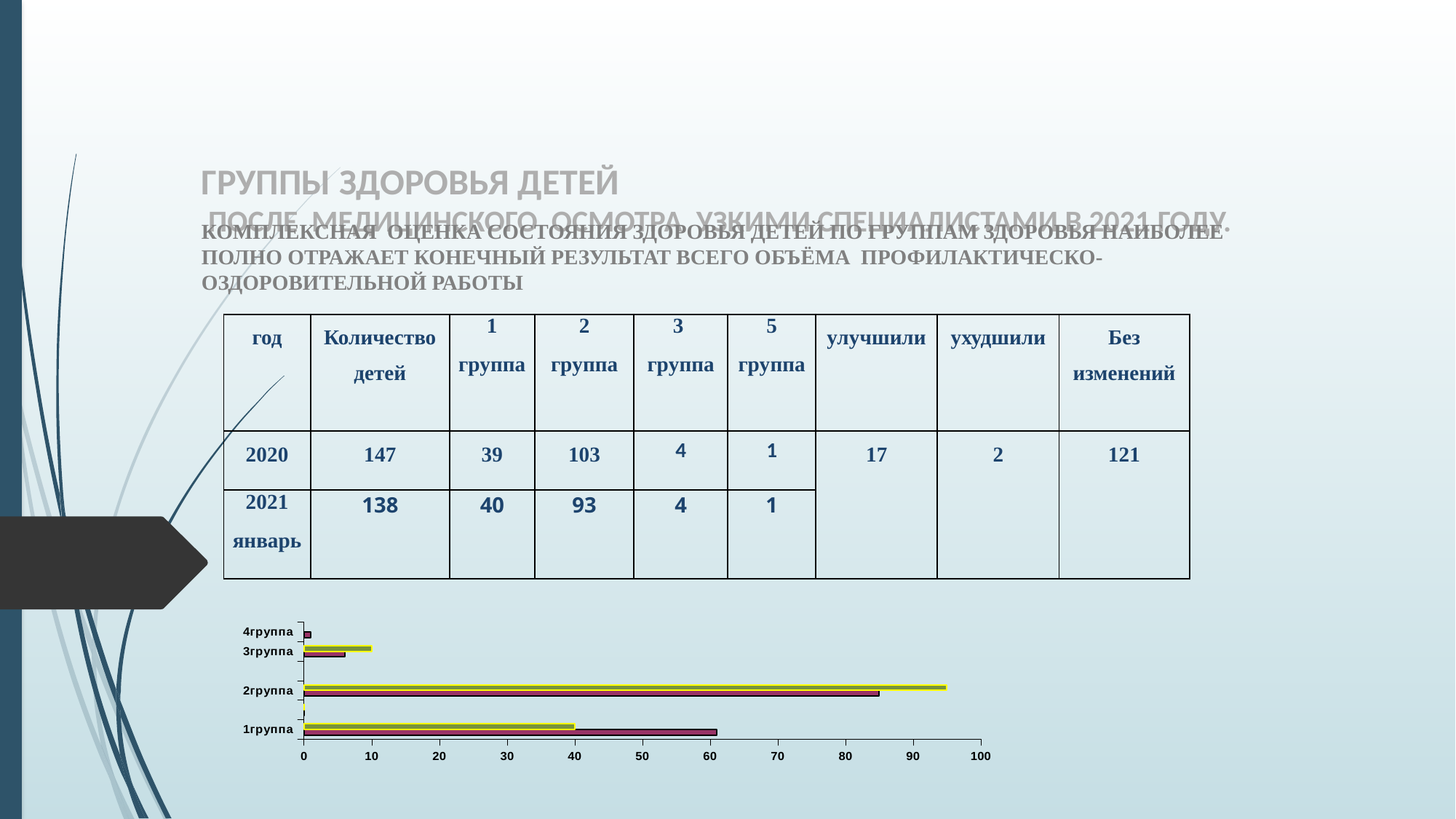
Which category has the shortest bars in the bar chart? 4группа For 1группа, which bar is longer, the yellow one or the dark red one? the dark red one Is the dark red bar for 2группа greater or less than 80? greater For 2группа, which bar is longer, the yellow one or the dark red one? the yellow one Is the dark red bar for 1группа greater or less than 50? greater Which category has the longest bars in the bar chart? 2группа Is the yellow bar for 2группа greater or less than 90? greater How many categories are shown on the vertical axis of the bar chart? 4 What is the highest value labelled on the horizontal axis of the bar chart? 100 What kind of chart is shown at the bottom of the slide? bar chart